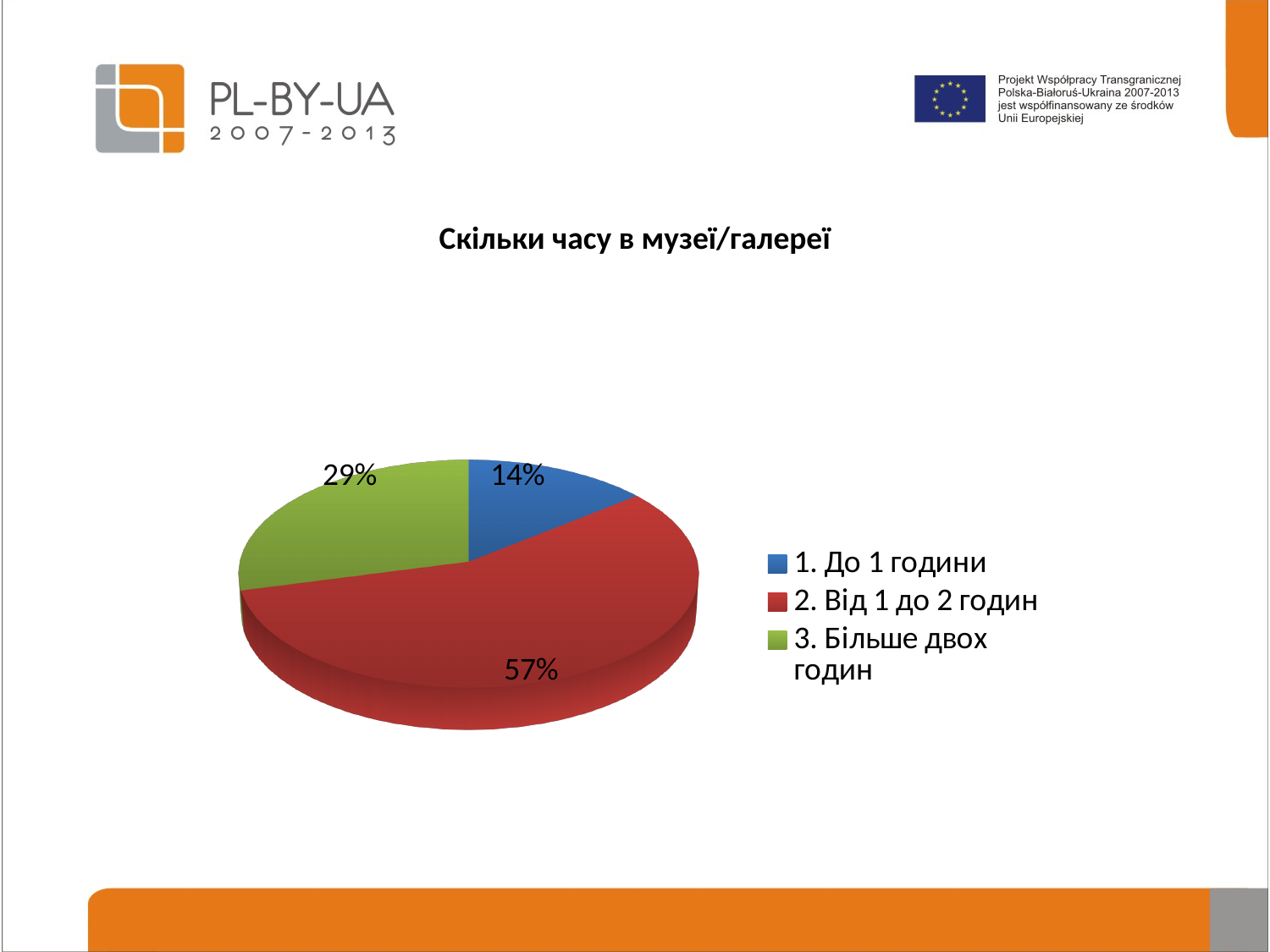
What is the title of the chart? Скільки часу в музеї/галереї How many categories are shown in the pie chart? 3 What share of the pie does "1. До 1 години" represent? 14% What is the difference in percentage points between "3. Більше двох годин" and "1. До 1 години"? 15 Which category has the smallest slice of the pie? 1. До 1 години Which category has the largest slice of the pie? 2. Від 1 до 2 годин What colour is the slice for "2. Від 1 до 2 годин"? Red Which is larger: the slice for "3. Більше двох годин" or the slice for "1. До 1 години"? 3. Більше двох годин What kind of chart is shown on the slide? Pie chart What share of the pie does "2. Від 1 до 2 годин" represent? 57% What is the difference in percentage points between "2. Від 1 до 2 годин" and "3. Більше двох годин"? 28 What share of the pie does "3. Більше двох годин" represent? 29%